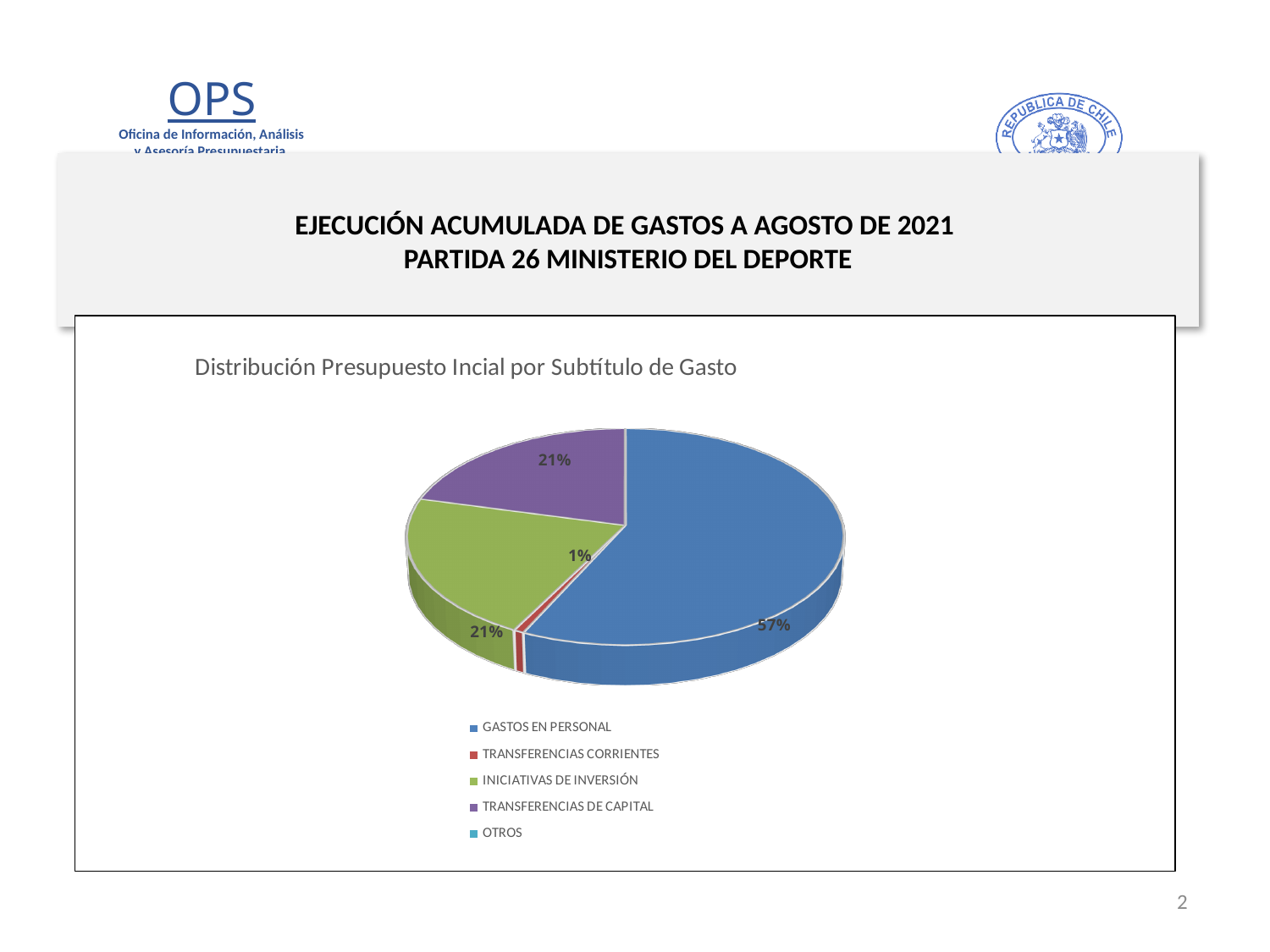
What is the difference in percentage points between GASTOS EN PERSONAL and INICIATIVAS DE INVERSIÓN? 36 percentage points What share of the pie does TRANSFERENCIAS CORRIENTES represent? 1% How many categories does the legend list? 5 Which is larger, the share for GASTOS EN PERSONAL or the share for TRANSFERENCIAS DE CAPITAL? GASTOS EN PERSONAL What share of the pie does INICIATIVAS DE INVERSIÓN represent? 21% What is the title of the chart? Distribución Presupuesto Incial por Subtítulo de Gasto What type of chart is shown on the slide? Pie chart What share of the pie does TRANSFERENCIAS DE CAPITAL represent? 21% What is the difference in percentage points between GASTOS EN PERSONAL and TRANSFERENCIAS CORRIENTES? 56 percentage points Which category has the largest slice of the pie? GASTOS EN PERSONAL What colour is the slice for GASTOS EN PERSONAL? Blue